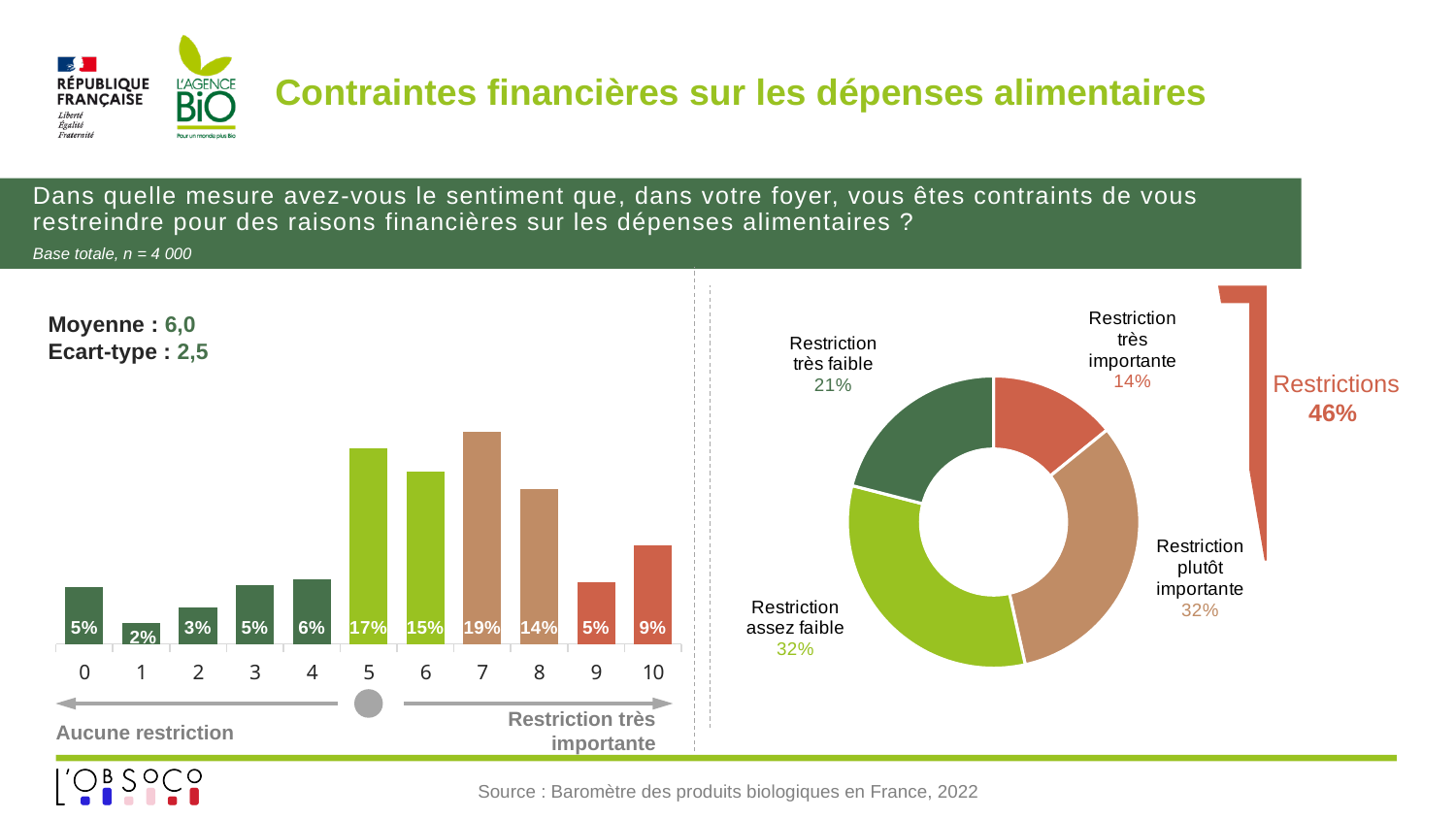
In the bar chart on the left, how many score categories are shown on the x axis? 11 In the bar chart on the left, what is the value for score 1? 2% What kind of chart is shown on the left of the slide? Bar chart In the bar chart on the left, what is the value for score 7? 19% In the bar chart on the left, which score has the lowest value? 1 In the bar chart on the left, which score has the highest value? 7 In the donut chart on the right, what is the share for 'Restriction très faible'? 21% In the donut chart on the right, how many slices are there? 4 In the bar chart on the left, which is larger, the value for score 8 or the value for score 10? 8 In the donut chart on the right, what is the share for 'Restriction très importante'? 14% In the donut chart on the right, what is the combined share of 'Restriction plutôt importante' and 'Restriction très importante'? 46% In the bar chart on the left, what is the difference between the values for score 5 and score 6? 2%